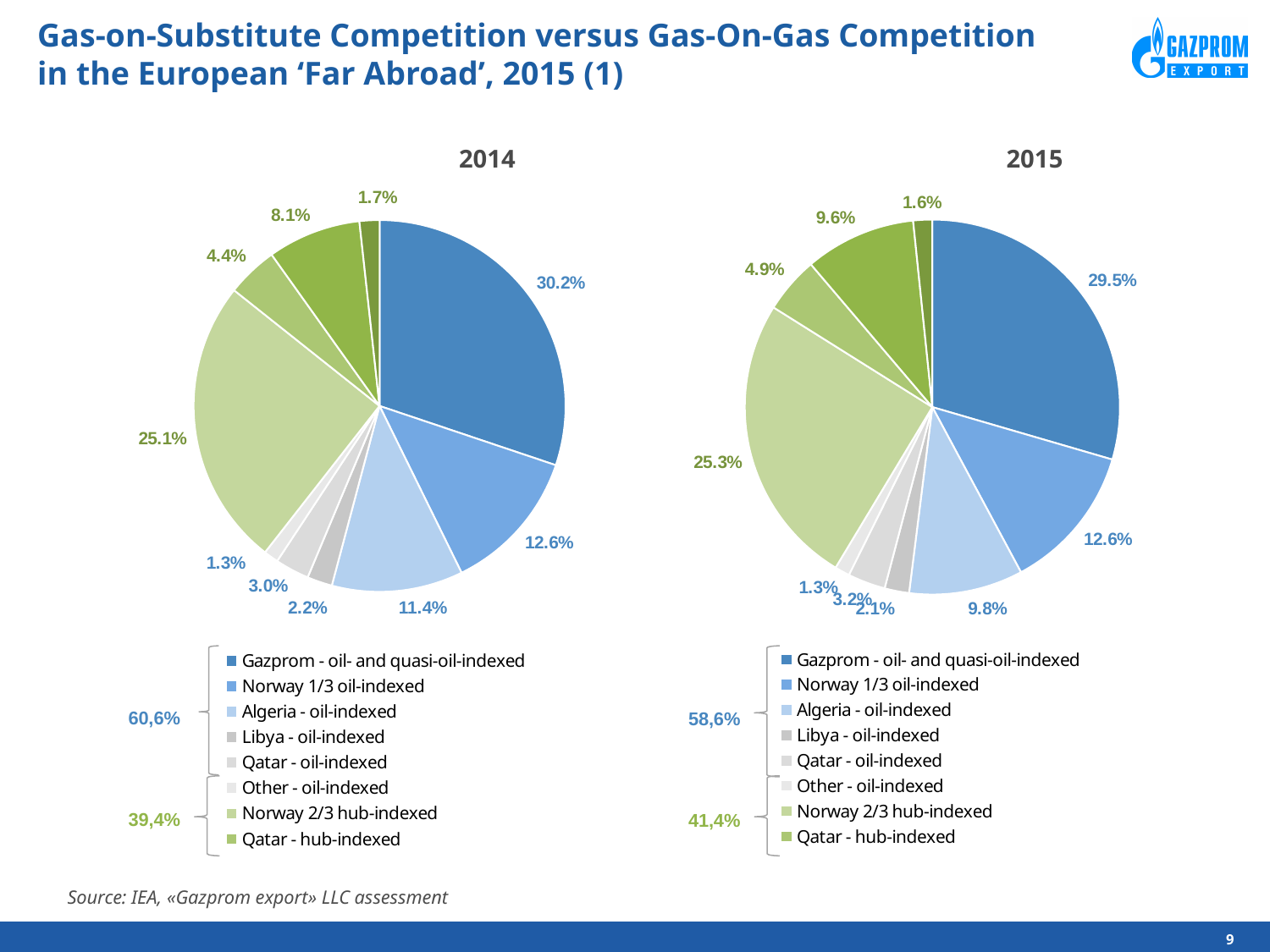
In the 2014 pie chart, which category has the largest slice? Gazprom - oil- and quasi-oil-indexed In the 2015 pie chart, what is the share for Algeria - oil-indexed? 9.8% In the 2015 pie chart, what share does Gazprom - oil- and quasi-oil-indexed have? 29.5% How many entries does the legend of the 2015 pie chart list? 8 In the 2014 chart, what total share is shown for the oil-indexed group in the legend bracket? 60,6% By how many percentage points did the Gazprom - oil- and quasi-oil-indexed share fall from the 2014 chart to the 2015 chart? 0.7 In the 2014 pie chart, what is the share for Norway 2/3 hub-indexed? 25.1% In the 2015 pie chart, what is the smallest labelled slice value? 1.3% In the 2015 chart, what total share is shown for the hub-indexed group in the legend bracket? 41,4% What kind of charts are shown on the slide? Pie charts Is the Algeria - oil-indexed share larger in the 2014 chart or the 2015 chart? 2014